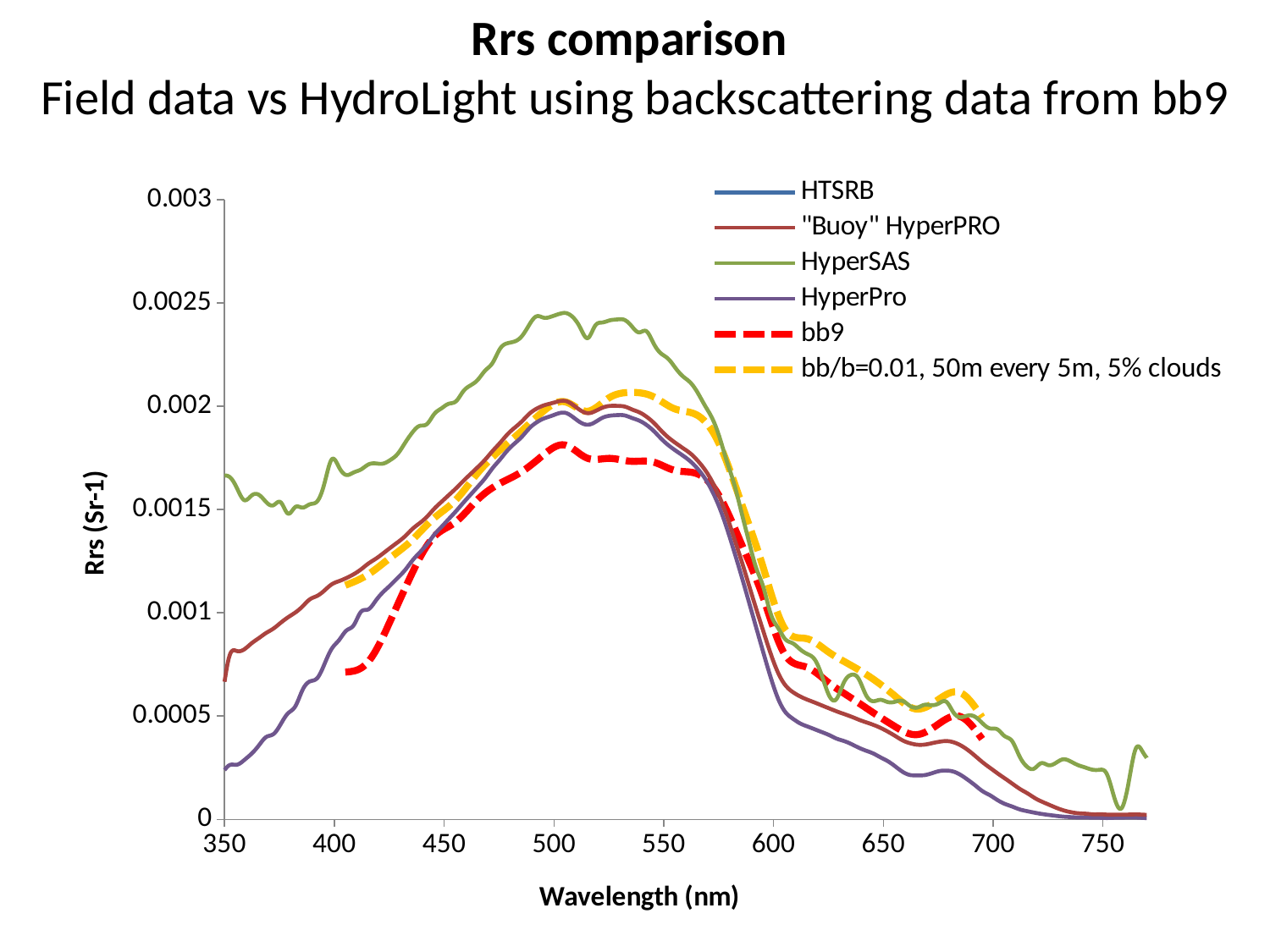
How many series does the legend list? 6 Is the value for HyperPro at 350 nm greater or less than 0.0005? less Which two series are drawn with dashed lines? bb9 and bb/b=0.01, 50m every 5m, 5% clouds What is the title of the vertical axis? Rrs (Sr-1) Which series has the highest value at 500 nm? HyperSAS Is the value for "Buoy" HyperPRO at 350 nm greater or less than 0.0005? greater What kind of chart is shown on the slide? line chart At 500 nm, which is larger: HyperSAS or bb9? HyperSAS Which series has the lowest value at 350 nm? HyperPro Is the value for HyperSAS at 500 nm greater or less than 0.002? greater Does the HyperPro series rise or fall between 600 nm and 750 nm? fall